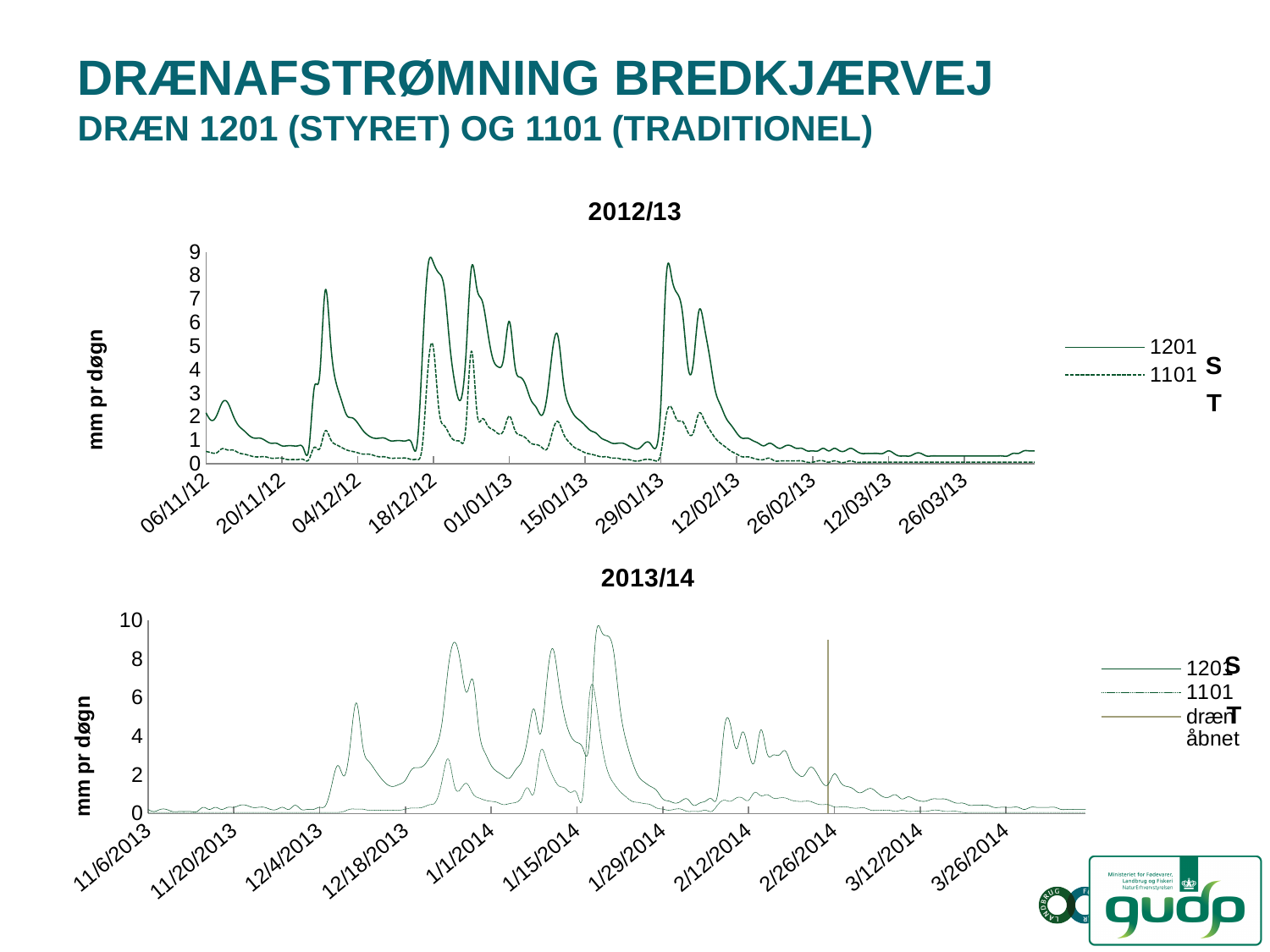
In the 2012/13 chart, is the highest value of series 1101 greater or less than 6? less What kind of chart is the 2012/13 chart? line chart How many series does the legend of the 2012/13 chart list? 2 In the 2012/13 chart, is the highest value of series 1201 greater or less than 8? greater In the 2012/13 chart, which series reaches the higher peak, 1201 or 1101? 1201 How many entries does the legend of the 2013/14 chart list? 3 In the 2013/14 chart, which series reaches the higher peak, 1201 or 1101? 1201 How many date labels are shown on the x axis of the 2013/14 chart? 11 In the 2013/14 chart, is the highest value of series 1201 greater or less than 8? greater What is the y-axis label of the 2013/14 chart? mm pr døgn In the 2012/13 chart, around 18/12/12, which series has the larger value, 1201 or 1101? 1201